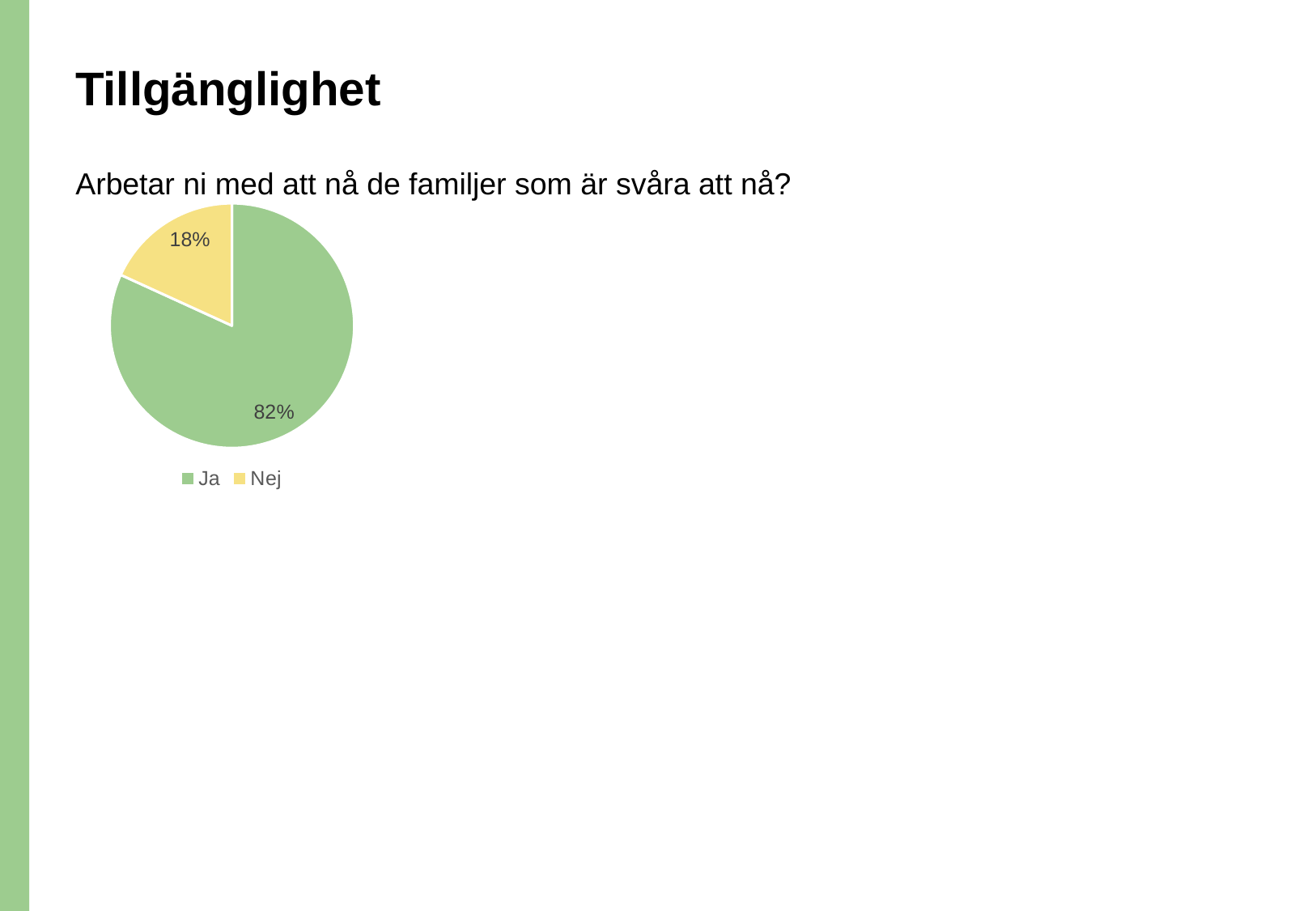
Which category has the smallest share of the pie chart? Nej What question does the pie chart answer, according to the text above it? Arbetar ni med att nå de familjer som är svåra att nå? What kind of chart is shown on the slide? Pie chart Which slice is larger, "Ja" or "Nej"? Ja How many slices does the pie chart have? 2 What is the difference in percentage points between the "Ja" and "Nej" slices? 64 What percentage of the pie chart is labelled "Ja"? 82% What percentage of the pie chart is labelled "Nej"? 18% What colour is the "Ja" slice in the pie chart? Green Which category has the largest share of the pie chart? Ja What share of the pie does the "Nej" slice represent? 18% How many entries does the legend list? 2